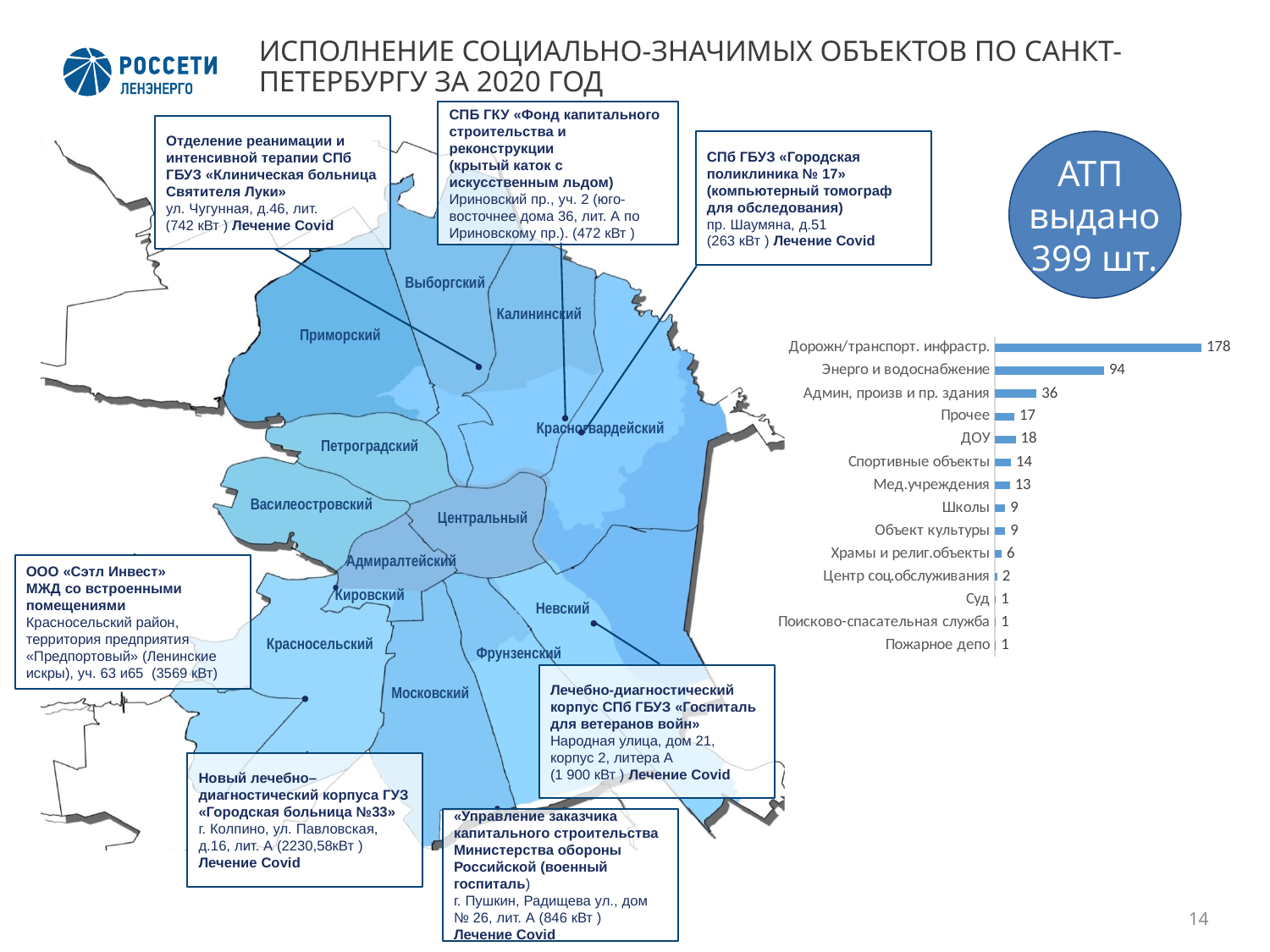
Which is larger in the bar chart: ДОУ or Прочее? ДОУ What value is shown for Дорожн/транспорт. инфрастр. in the bar chart? 178 Which category has the highest value in the bar chart? Дорожн/транспорт. инфрастр. How many categories in the bar chart have a value of 1? 3 What value is shown for Энерго и водоснабжение in the bar chart? 94 What kind of chart is shown on the slide? Bar chart Which is larger in the bar chart: Спортивные объекты or Мед.учреждения? Спортивные объекты What is the difference between the values for Дорожн/транспорт. инфрастр. and Энерго и водоснабжение? 84 What value is shown for Храмы и религ.объекты in the bar chart? 6 What is the difference between the values for Админ, произв и пр. здания and Прочее? 19 How many categories are shown in the bar chart? 14 What value is shown for ДОУ in the bar chart? 18